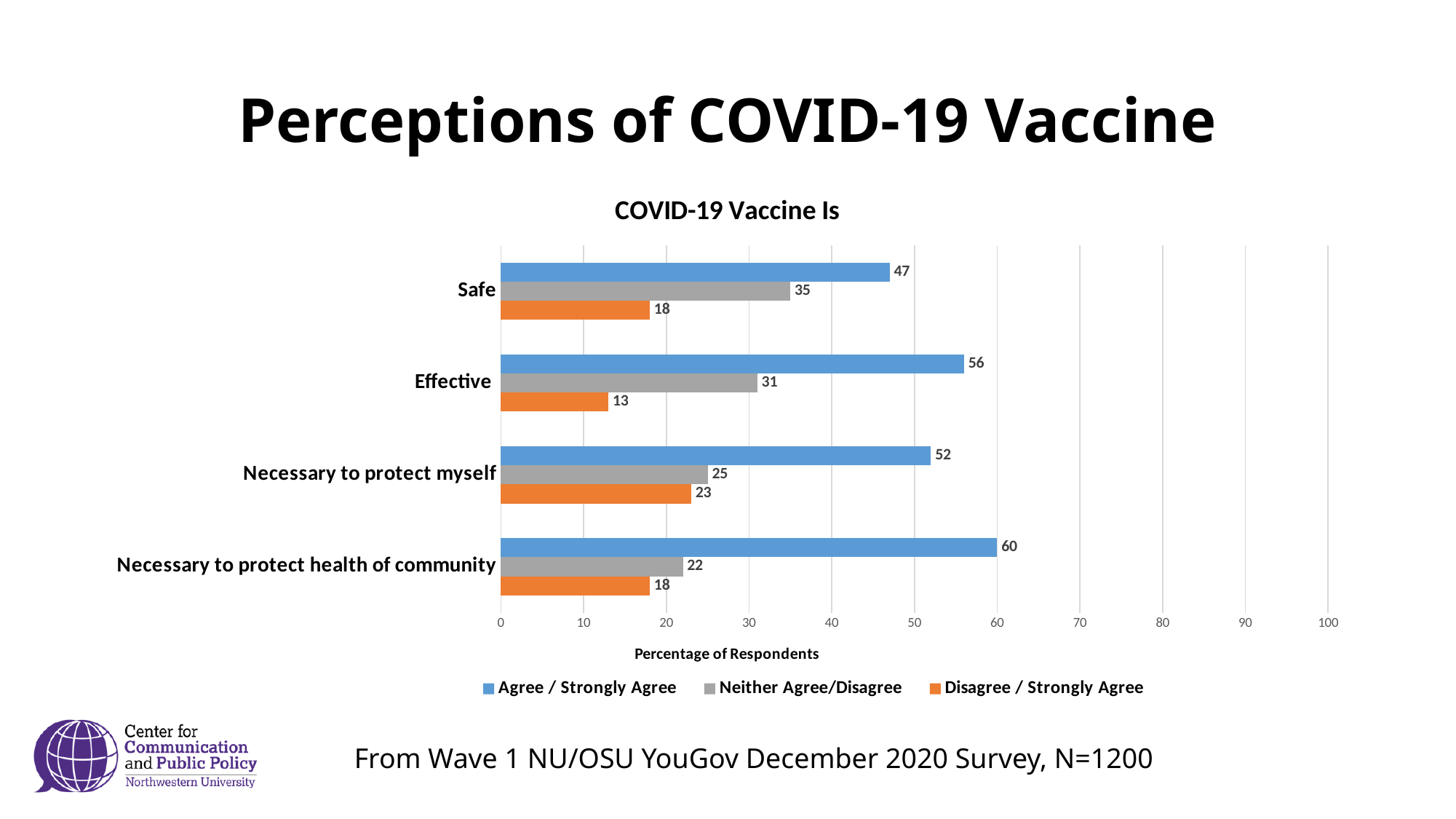
Which statement has the lowest Disagree / Strongly Agree value? Effective What is the value for Disagree / Strongly Agree for the statement that the vaccine is effective? 13 Which is larger: the Neither Agree/Disagree value for 'Safe' or for 'Effective'? Safe How many statements (categories) are shown on the chart? 4 What kind of chart is shown on the slide? Bar chart How many series does the legend list? 3 Which statement has the highest Agree / Strongly Agree value? Necessary to protect health of community What is the title of the chart? COVID-19 Vaccine Is What percentage of respondents agree or strongly agree that the COVID-19 vaccine is safe? 47 What is the difference between the Agree / Strongly Agree values for 'Effective' and 'Safe'? 9 What is the label of the horizontal axis? Percentage of Respondents What is the Neither Agree/Disagree value for 'Necessary to protect myself'? 25